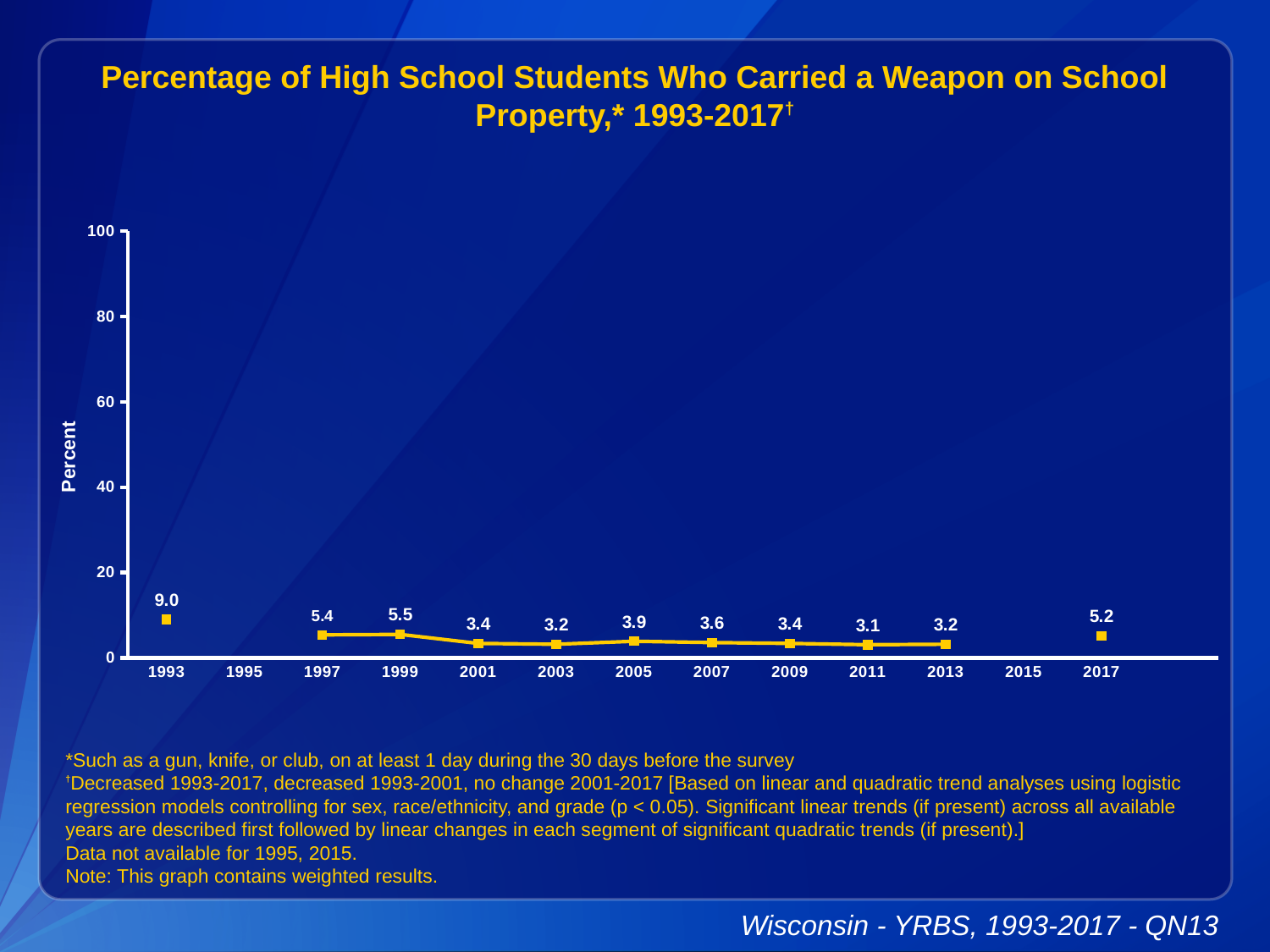
Is the value for 1993 greater or less than 20? less What is the value plotted for 2017? 5.2 Which year has the lowest percentage? 2011 What percentage of high school students carried a weapon on school property in 1993? 9.0 What is the value plotted for 2005? 3.9 What kind of chart is shown on the slide? line chart Which year has a larger value, 1997 or 2013? 1997 What is the label on the vertical axis? Percent What is the difference between the 1999 value and the 2001 value? 2.1 What is the difference between the 1993 value and the 2017 value? 3.8 Which year has the highest percentage? 1993 How many years have a data point plotted on the chart? 11